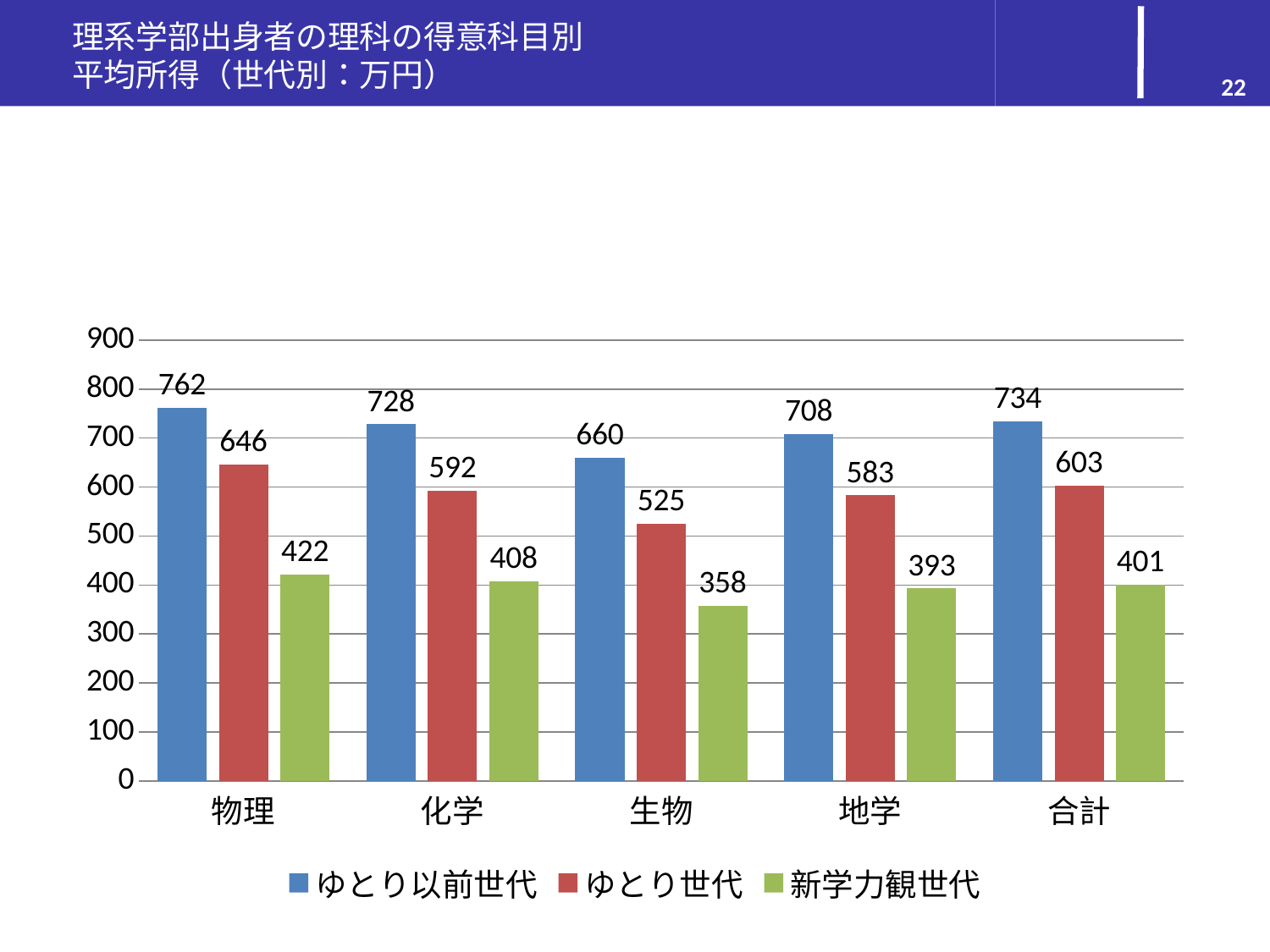
How many series does the legend list? 3 What is the value for 新学力観世代 in the 生物 category? 358 What is the difference between ゆとり以前世代 and ゆとり世代 in the 化学 category? 136 What kind of chart is shown on the slide? bar chart How many categories are shown on the x axis? 5 Which category has the lowest value for 新学力観世代? 生物 Which category has the highest value for ゆとり以前世代? 物理 What is the value for ゆとり世代 in the 合計 category? 603 What colour are the bars for 新学力観世代? green Is the value for 新学力観世代 in 地学 greater or less than 400? less Which is larger: ゆとり世代 for 物理 or ゆとり世代 for 地学? ゆとり世代 for 物理 What is the value for ゆとり以前世代 in the 物理 category? 762